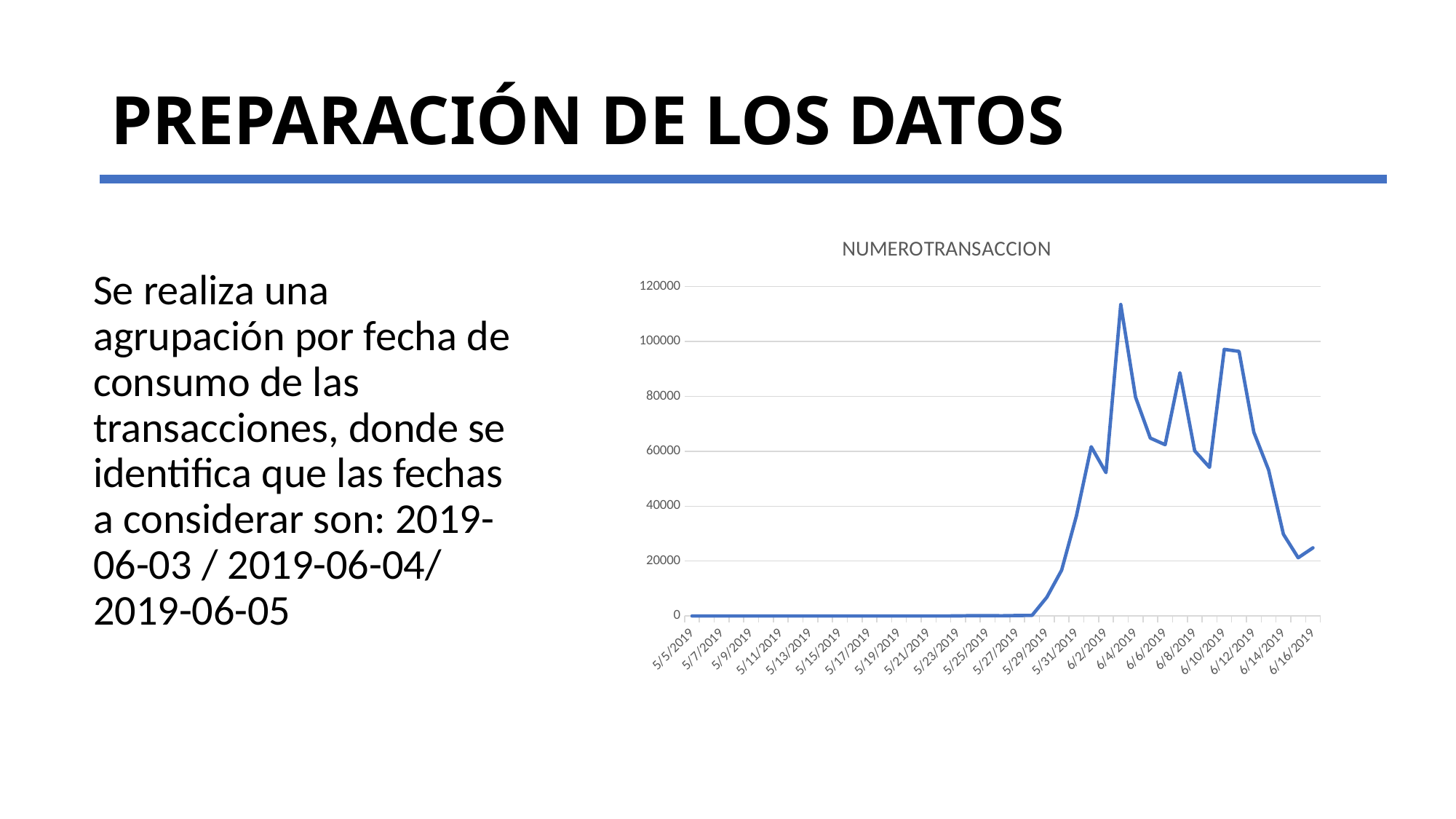
Is the value for 6/4/2019 greater or less than 60000? greater Is the value for 6/14/2019 greater or less than 40000? less What kind of chart is shown on the slide? line chart Do the values rise or fall between 6/12/2019 and 6/14/2019? fall Is the value for 6/10/2019 greater or less than 80000? greater Which date has the larger value, 6/10/2019 or 6/16/2019? 6/10/2019 What is the title of the chart? NUMEROTRANSACCION Which date has the larger value, 6/4/2019 or 6/14/2019? 6/4/2019 What is the highest value shown on the chart's vertical axis? 120000